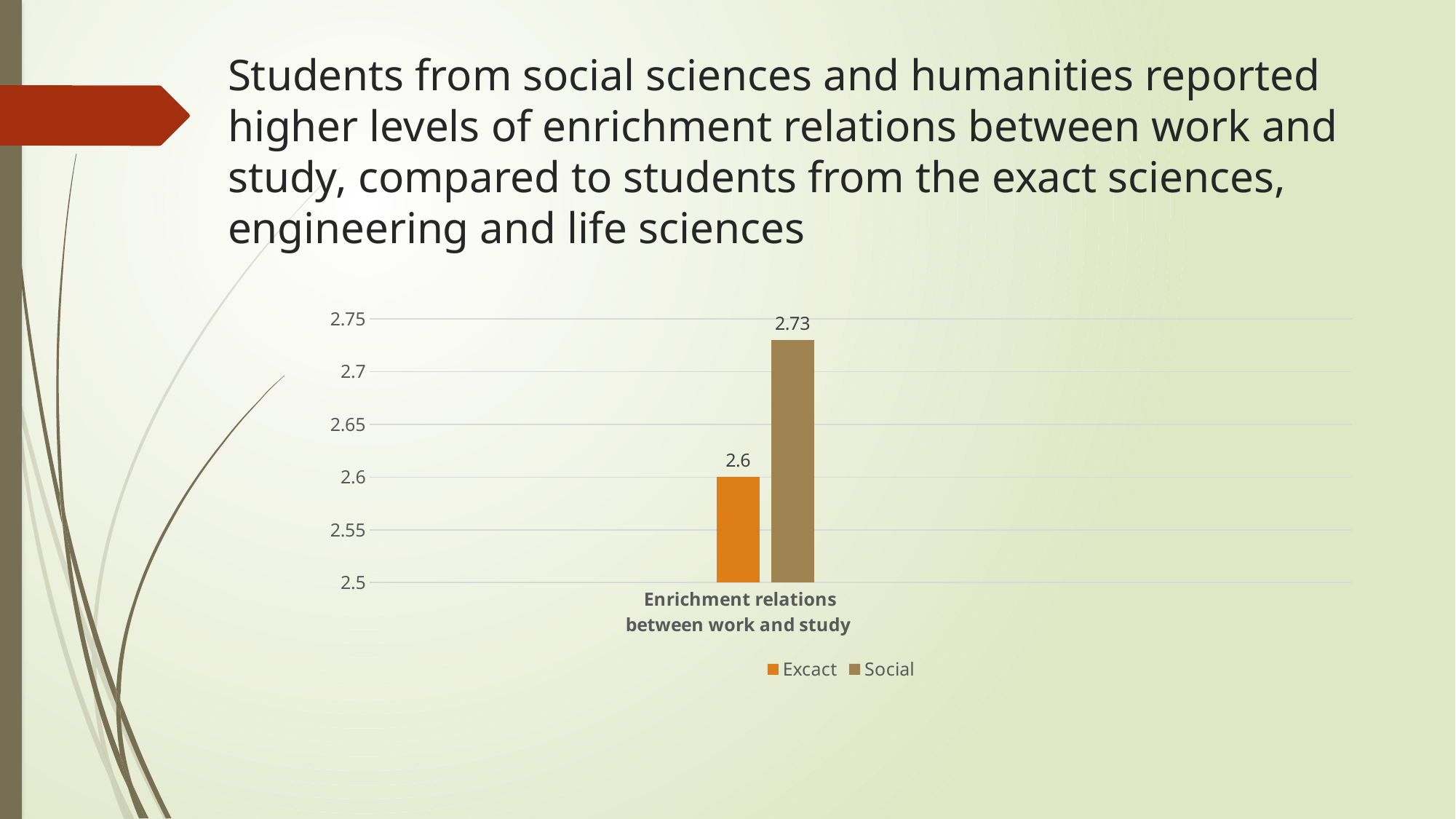
What is the difference between the Social value and the Excact value? 0.13 What is the value for the Social series in the chart? 2.73 What is the category label shown on the x axis? Enrichment relations between work and study How many categories are shown on the x axis? 1 What kind of chart is shown on the slide? Bar chart Which series has the lowest value in the chart? Excact Which series has the higher value, Excact or Social? Social Is the value for Social greater or less than 2.7? greater Is the value for Excact greater or less than 2.65? less What is the value for the Excact series in the chart? 2.6 Which series has the highest value in the chart? Social How many series does the legend list? 2